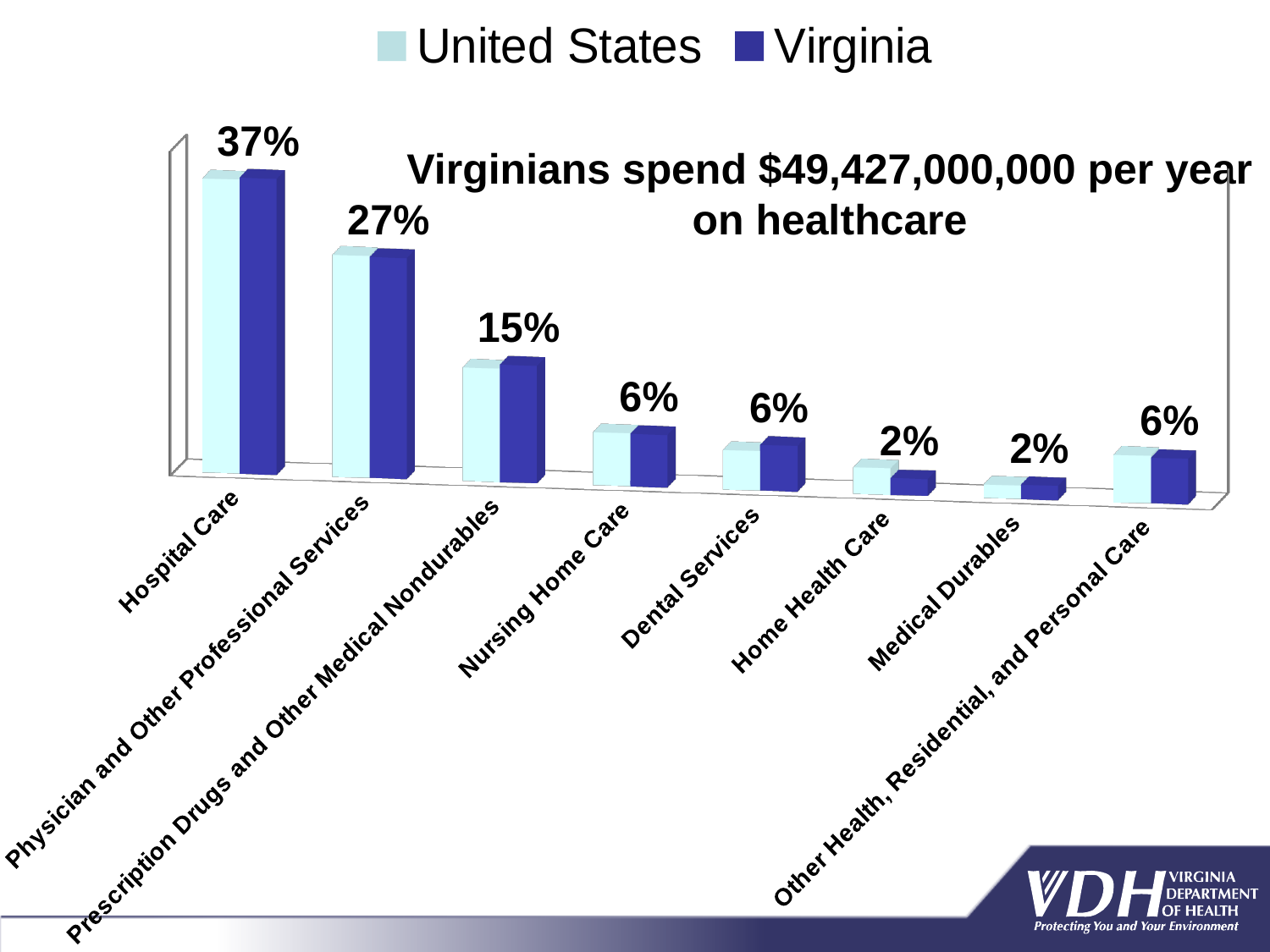
What percentage label is shown for Other Health, Residential, and Personal Care? 6% What percentage label is shown for Hospital Care? 37% What kind of chart is shown on the slide? Bar chart What is the difference between the labelled percentages for Hospital Care and Physician and Other Professional Services? 10% What are the two series named in the legend? United States and Virginia Which category has the highest percentage on the chart? Hospital Care How many series does the legend list? 2 What percentage label is shown for Prescription Drugs and Other Medical Nondurables? 15% How many categories are shown on the chart? 8 What percentage label is shown for Physician and Other Professional Services? 27% Which has a larger labelled percentage, Prescription Drugs and Other Medical Nondurables or Nursing Home Care? Prescription Drugs and Other Medical Nondurables What percentage label is shown for Home Health Care? 2%